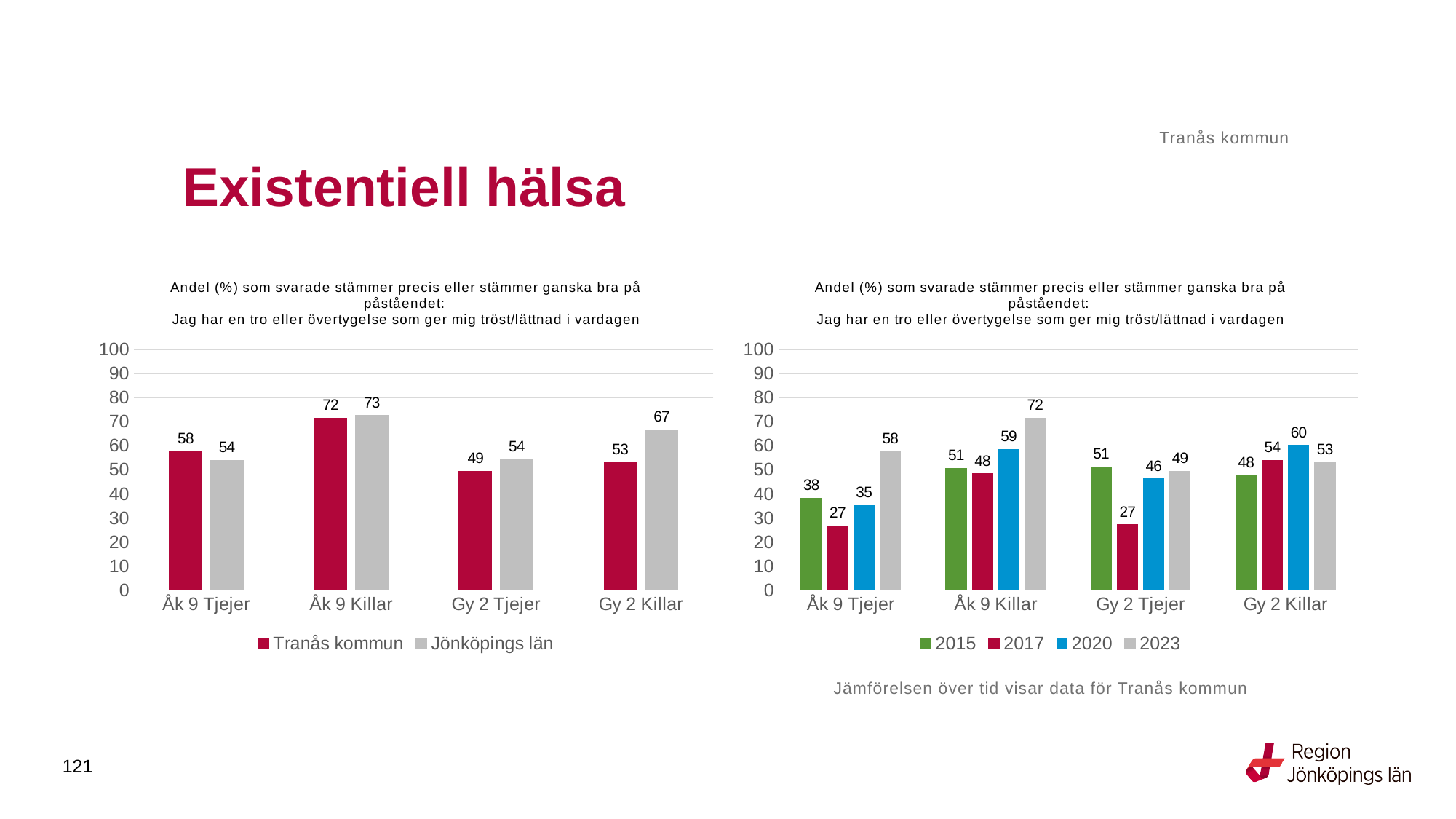
In the right chart, which year has the lowest value for Gy 2 Tjejer? 2017 In the right chart, what is the value for 2017 for Åk 9 Tjejer? 27 In the left chart, what is the value for Tranås kommun for Åk 9 Tjejer? 58 In the left chart, how many series does the legend list? 2 In the left chart, which category has the highest value for Tranås kommun? Åk 9 Killar In the left chart, what is the value for Jönköpings län for Gy 2 Killar? 67 In the right chart, what is the value for 2023 for Åk 9 Killar? 72 In the left chart, what is the difference between Jönköpings län and Tranås kommun for Gy 2 Killar? 14 In the right chart, what is the difference between 2023 and 2015 for Åk 9 Tjejer? 20 In the right chart, which is larger for Gy 2 Killar: 2020 or 2023? 2020 What kind of chart is the left chart? Bar chart In the right chart, how many series does the legend list? 4